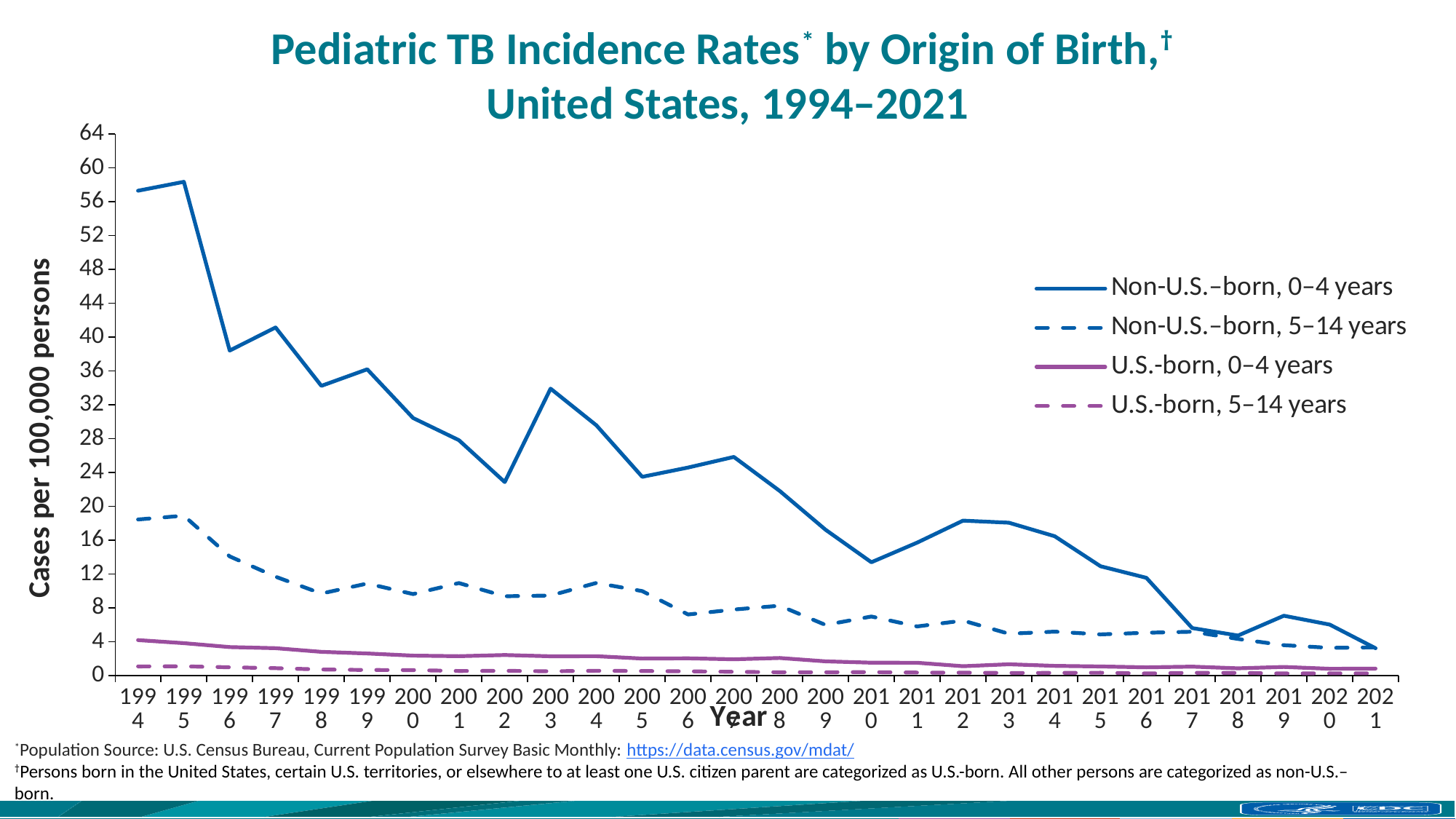
Is the value for U.S.-born, 0–4 years in 1994 greater or less than 8? less Does the Non-U.S.–born, 0–4 years line generally rise or fall from 1994 to 2021? Fall How many series does the legend list? 4 How many years are plotted along the x axis? 28 What kind of chart is shown on the slide? Line chart Is the value for Non-U.S.–born, 0–4 years in 1994 greater or less than 52? greater Is the value for Non-U.S.–born, 5–14 years in 1994 greater or less than 16? greater In 2003, which is larger: the value for Non-U.S.–born, 0–4 years or Non-U.S.–born, 5–14 years? Non-U.S.–born, 0–4 years Which series has the lowest values across the chart? U.S.-born, 5–14 years What is the title of the y axis? Cases per 100,000 persons Which series has the highest value in 1994? Non-U.S.–born, 0–4 years